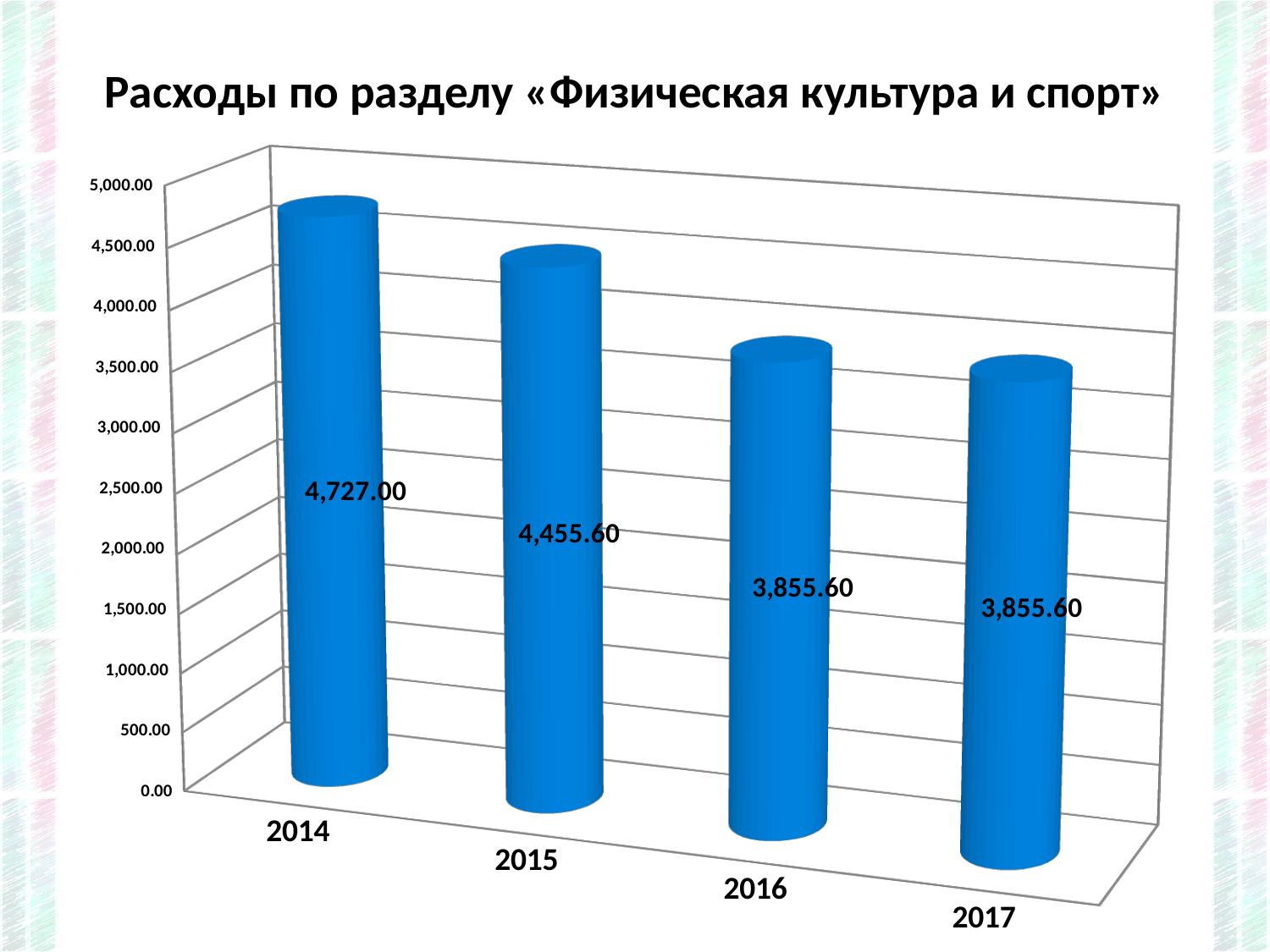
Which is larger, the value for 2014 or the value for 2016? 2014 What is the value for 2015? 4,455.60 What kind of chart is shown on the slide? bar chart What is the difference between the values for 2014 and 2015? 271.40 What is the value for 2014? 4,727.00 What is the value for 2017? 3,855.60 What is the value for 2016? 3,855.60 Which year has the highest value? 2014 Do the values rise or fall from 2014 to 2017? fall How many years are shown on the chart? 4 Is the value for 2015 greater or less than 4,000.00? greater What is the difference between the values for 2015 and 2016? 600.00